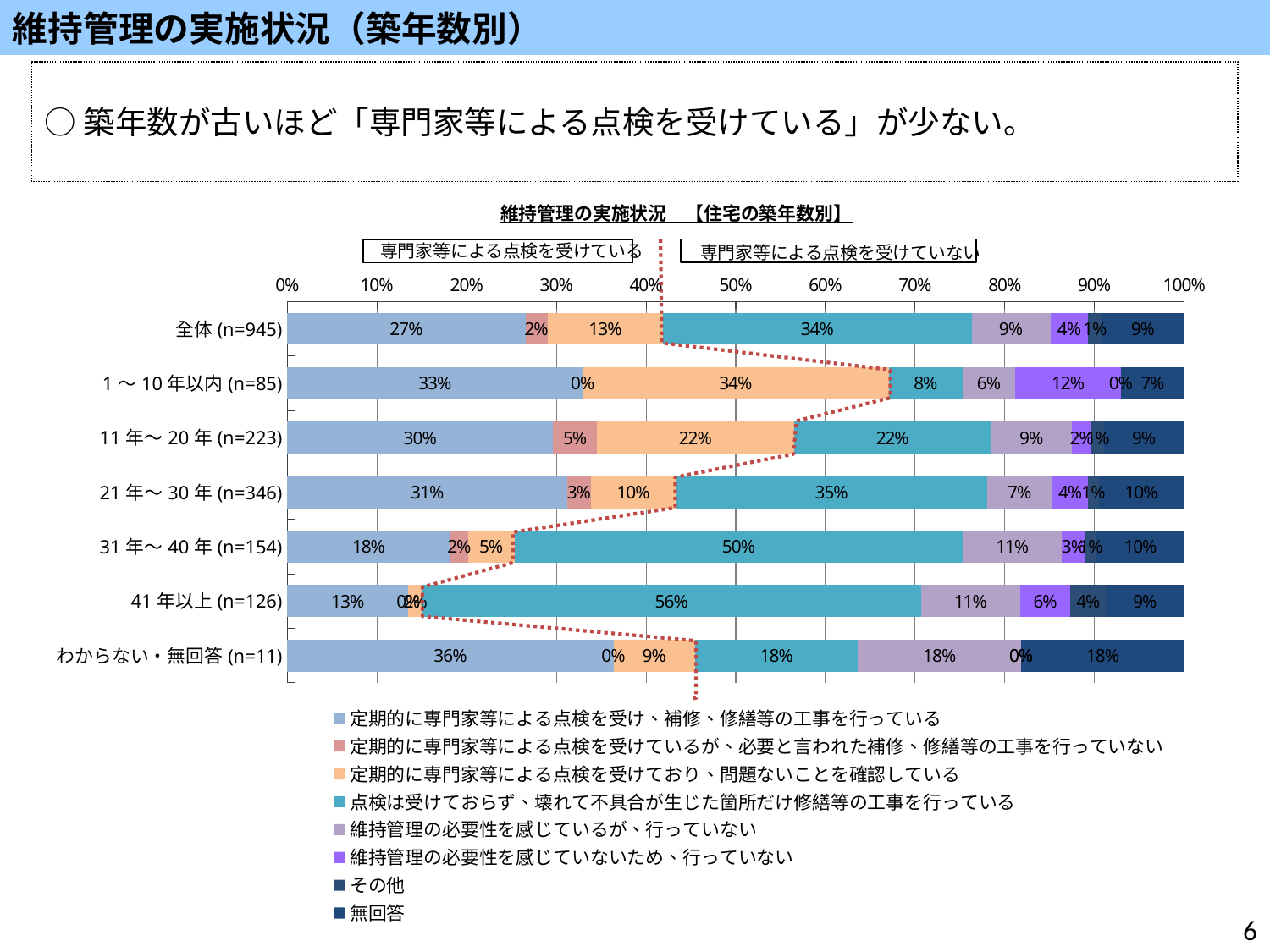
What is the title of the chart? 維持管理の実施状況 【住宅の築年数別】 What is the value of 「点検は受けておらず、壊れて不具合が生じた箇所だけ修繕等の工事を行っている」 for 31年～40年 (n=154)? 50% How many series does the legend list? 8 Among the age-band categories, which has the lowest value for 「定期的に専門家等による点検を受け、補修、修繕等の工事を行っている」? 41年以上 (n=126) What kind of chart is shown on the slide? Stacked bar chart For 全体 (n=945), what is the difference between 「点検は受けておらず、壊れて不具合が生じた箇所だけ修繕等の工事を行っている」 (34%) and 「定期的に専門家等による点検を受け、補修、修繕等の工事を行っている」 (27%)? 7 percentage points What is the value of 「点検は受けておらず、壊れて不具合が生じた箇所だけ修繕等の工事を行っている」 for 21年～30年 (n=346)? 35% What is the value of 「定期的に専門家等による点検を受け、補修、修繕等の工事を行っている」 for 全体 (n=945)? 27% Which has the larger value for 「定期的に専門家等による点検を受け、補修、修繕等の工事を行っている」: 1～10年以内 (n=85) or 41年以上 (n=126)? 1～10年以内 (n=85) How many categories (bars) are plotted in the chart? 7 What is the value of 「定期的に専門家等による点検を受けており、問題ないことを確認している」 for 1～10年以内 (n=85)? 34% Which category has the highest value for 「点検は受けておらず、壊れて不具合が生じた箇所だけ修繕等の工事を行っている」? 41年以上 (n=126)